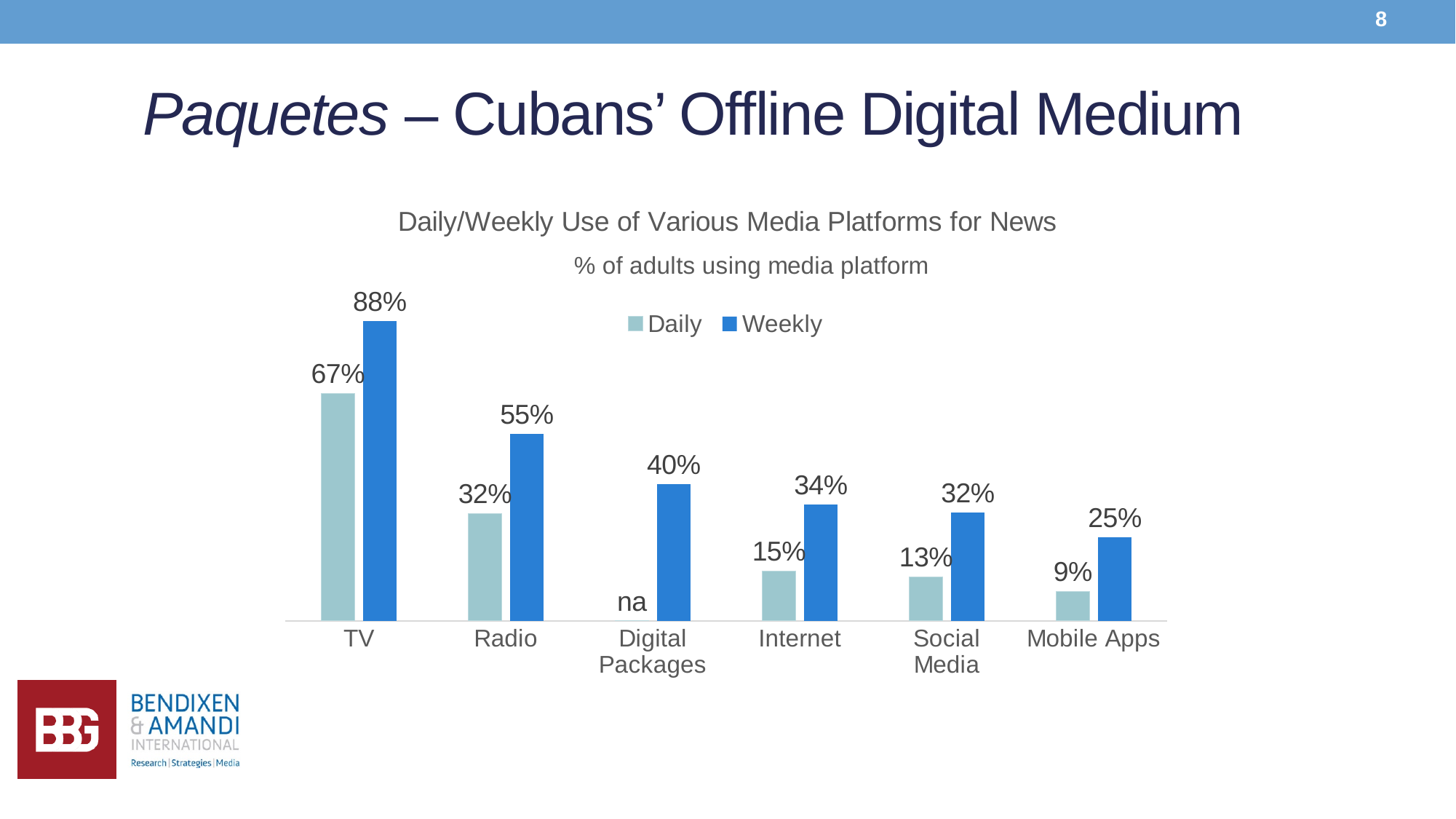
How many media platforms are shown on the x axis? 6 Which is larger, the Weekly value for Internet or the Weekly value for Social Media? Internet What is the Weekly value for TV? 88% How many series does the legend list? 2 What is the Weekly value for Digital Packages? 40% Which platform has the highest Weekly value? TV Which platform has the lowest Daily value among those with a value shown? Mobile Apps What is the Daily value for Radio? 32% What is shown in place of the Daily value for Digital Packages? na What kind of chart is shown on the slide? Bar chart What is the Daily value for Mobile Apps? 9% What is the difference between the Weekly and Daily values for TV? 21%